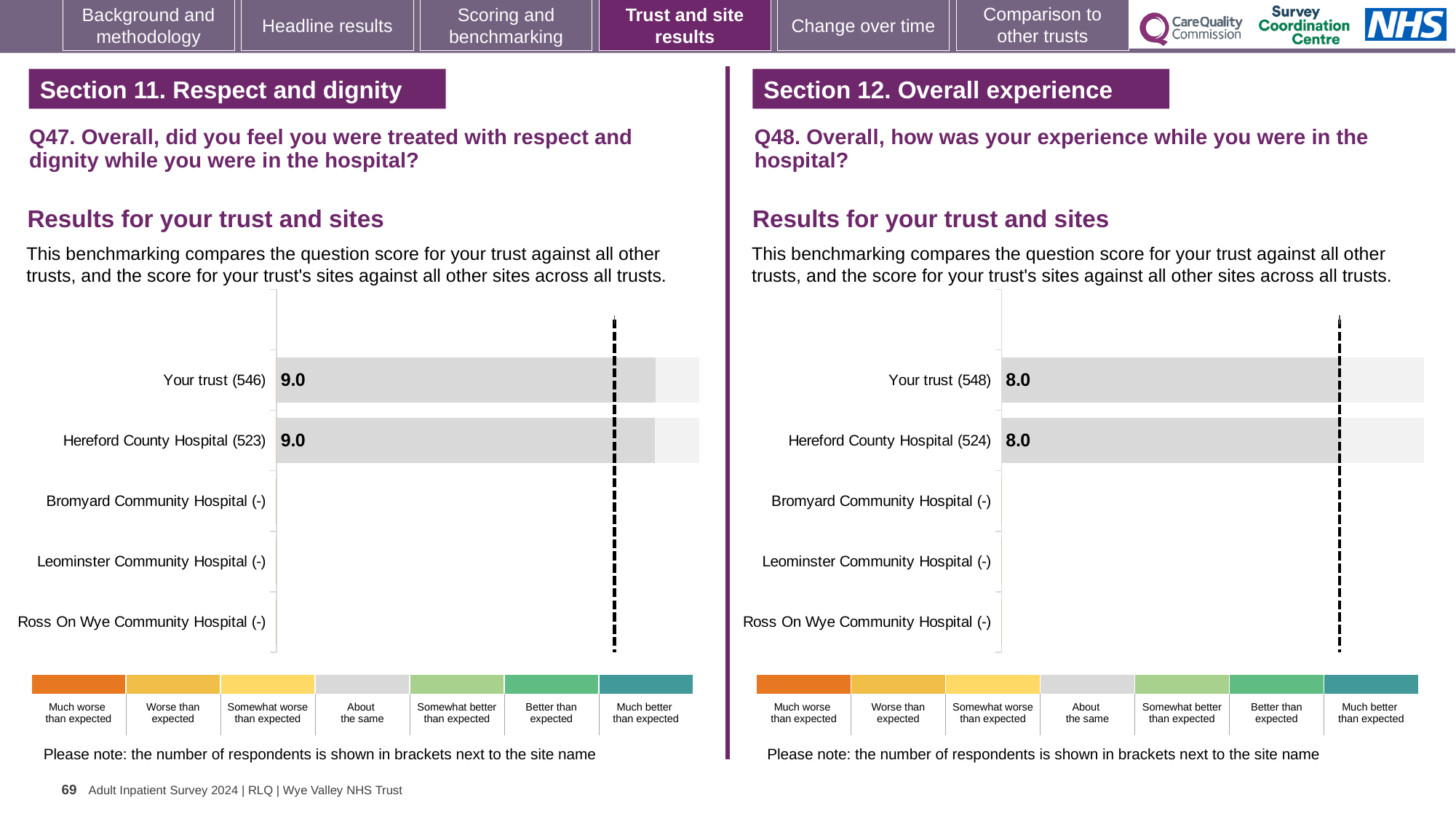
On the Q48 chart (right), how many respondents are shown in brackets for Hereford County Hospital? 524 On the Q47 chart (left), how many respondents are shown in brackets for Your trust? 546 On the Q47 chart (left), what is the difference between the score for Your trust and the score for Hereford County Hospital? 0.0 On the Q47 chart (left), what is the score for Your trust? 9.0 On the Q48 chart (right), what is the difference between the score for Your trust and the score for Hereford County Hospital? 0.0 On the Q48 chart (right), what is the score for Your trust? 8.0 On the Q47 chart (left), what is the score for Hereford County Hospital? 9.0 On the Q48 chart (right), what is the score for Hereford County Hospital? 8.0 On the Q47 chart (left), how many sites or categories are listed on the vertical axis? 5 What kind of chart is used on the Q47 chart (left)? Bar chart Is the score for Your trust on the Q47 chart (left) larger or smaller than the score for Your trust on the Q48 chart (right)? Larger On the Q48 chart (right), how many sites or categories are listed on the vertical axis? 5